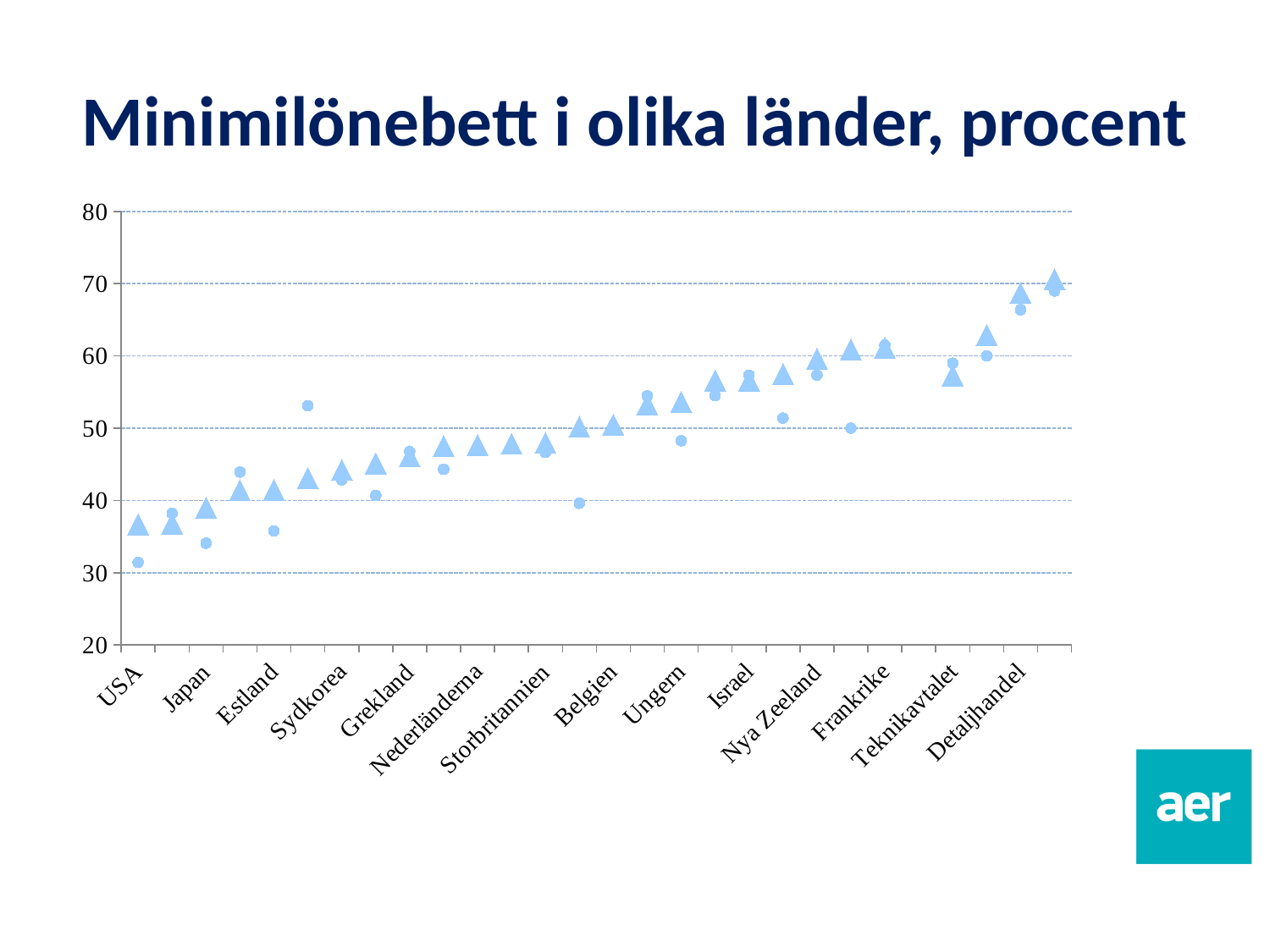
What is the title of the chart? Minimilönebett i olika länder, procent Do the plotted values generally rise or fall from left to right along the x axis? rise What kind of chart is shown on the slide? scatter chart Is the triangle-marker value for Teknikavtalet greater or less than 60? less How many category labels are shown on the x axis? 14 Which labelled category has the highest plotted values? Detaljhandel Is the circle-marker value for Sydkorea greater or less than 50? less Which labelled category has the lowest plotted values? USA Is the triangle-marker value for Sydkorea greater or less than 50? less